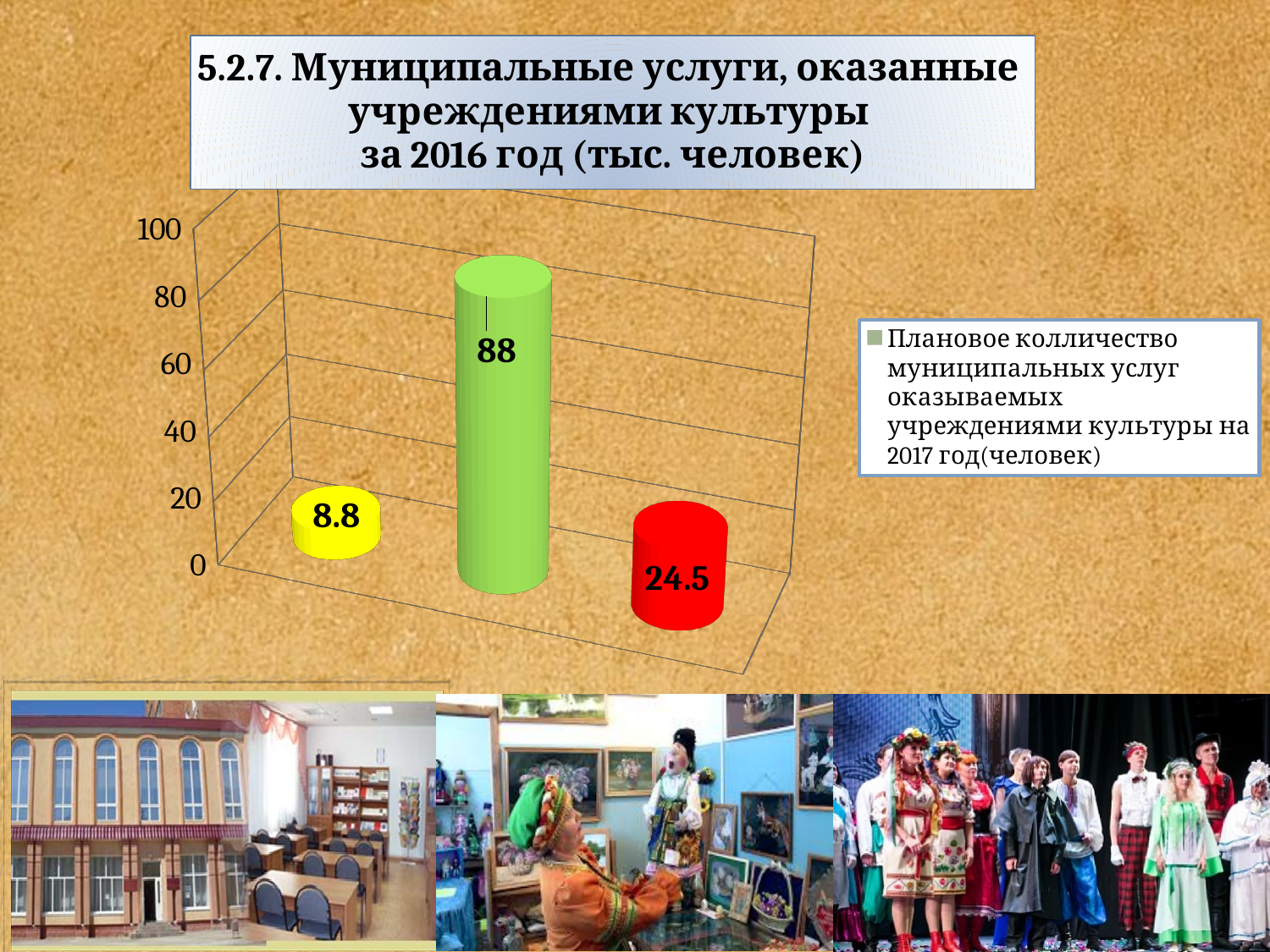
What value is shown on the yellow bar? 8.8 How many bars are plotted in the chart? 3 Which bar has the highest value? The green bar (88) What value is shown on the green bar? 88 Which bar has the lowest value? The yellow bar (8.8) Which is larger, the red bar or the yellow bar? The red bar What is the difference between the red bar and the yellow bar? 15.7 What value is shown on the red bar? 24.5 What is the highest value shown on the vertical axis? 100 What is the difference between the green bar and the red bar? 63.5 Is the value of the green bar greater or less than 80? greater What type of chart is shown on the slide? Bar chart